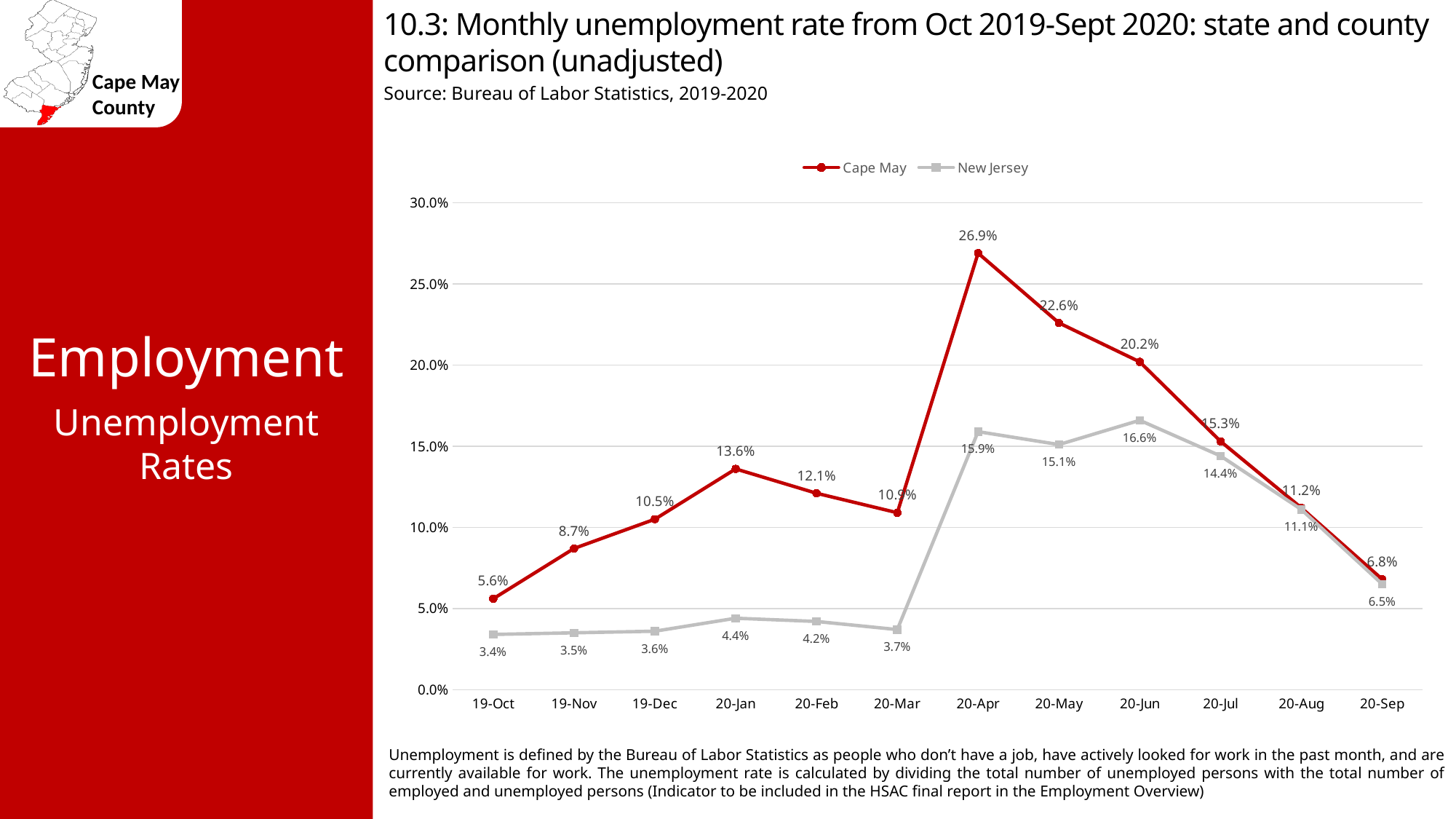
What was the Cape May unemployment rate in 20-Apr? 26.9% What is the source cited for the chart? Bureau of Labor Statistics, 2019-2020 Which series had the higher unemployment rate in 20-Jan, Cape May or New Jersey? Cape May Did the Cape May unemployment rate rise or fall from 20-Apr to 20-Sep? Fall How many months are plotted along the x axis? 12 In which month did New Jersey have its lowest unemployment rate? 19-Oct How many series does the legend list? 2 What type of chart is shown on the slide? Line chart What is the difference between the Cape May and New Jersey unemployment rates in 20-Apr? 11.0% In which month did Cape May have its highest unemployment rate? 20-Apr What is the difference between the Cape May unemployment rate in 20-Apr and in 20-May? 4.3% What was the New Jersey unemployment rate in 20-Jun? 16.6%